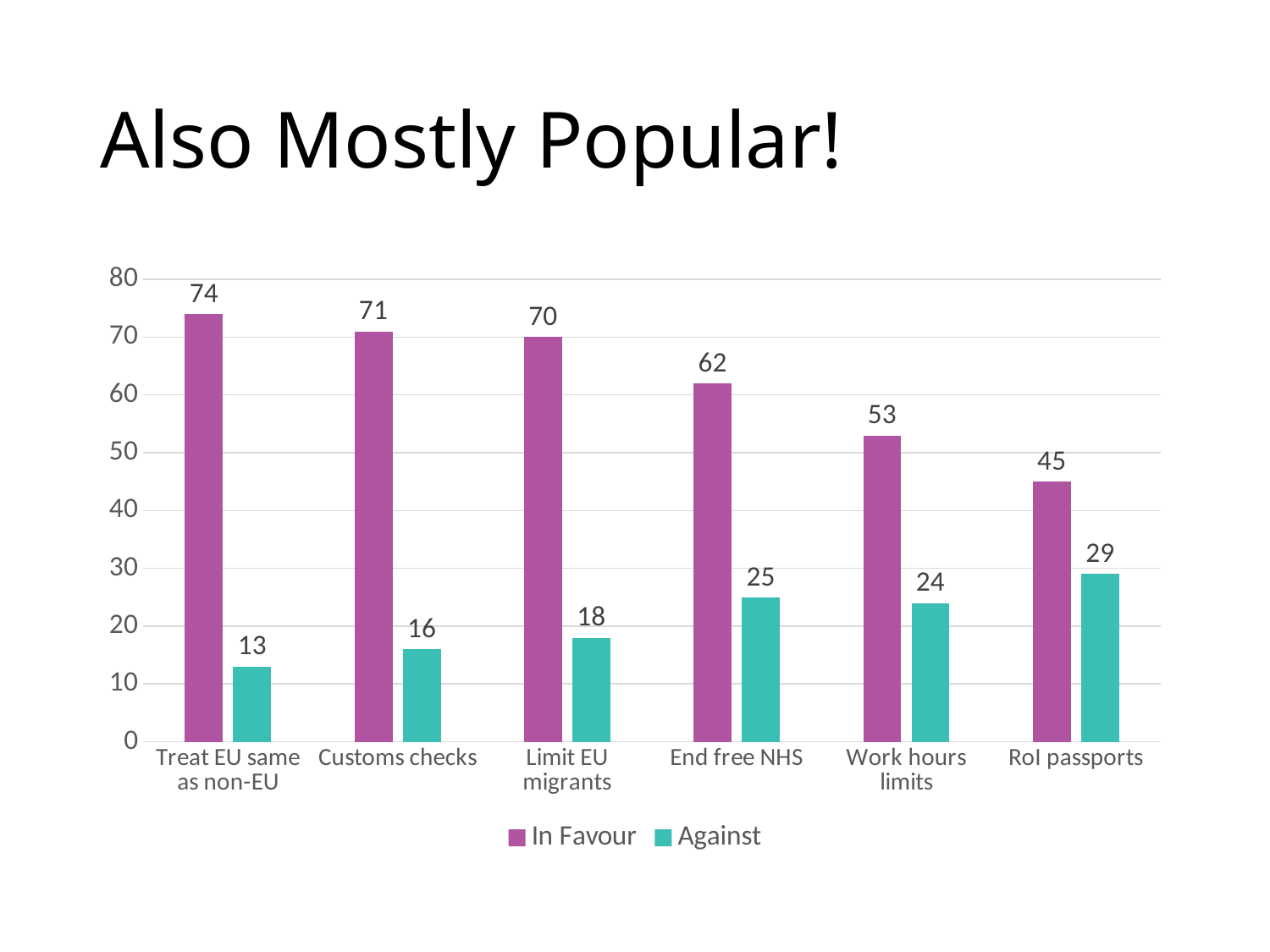
How many categories are shown on the x axis? 6 What is the Against value for End free NHS? 25 Which is larger: the Against value for RoI passports or the Against value for Limit EU migrants? RoI passports What is the In Favour value for RoI passports? 45 Which category has the highest In Favour value? Treat EU same as non-EU What kind of chart is shown on the slide? Bar chart What is the In Favour value for Customs checks? 71 Is the In Favour value for End free NHS greater or less than 60? greater Do the In Favour values rise or fall from left to right along the x axis? Fall Which category has the lowest Against value? Treat EU same as non-EU How many series does the legend list? 2 What is the difference between the In Favour and Against values for Work hours limits? 29